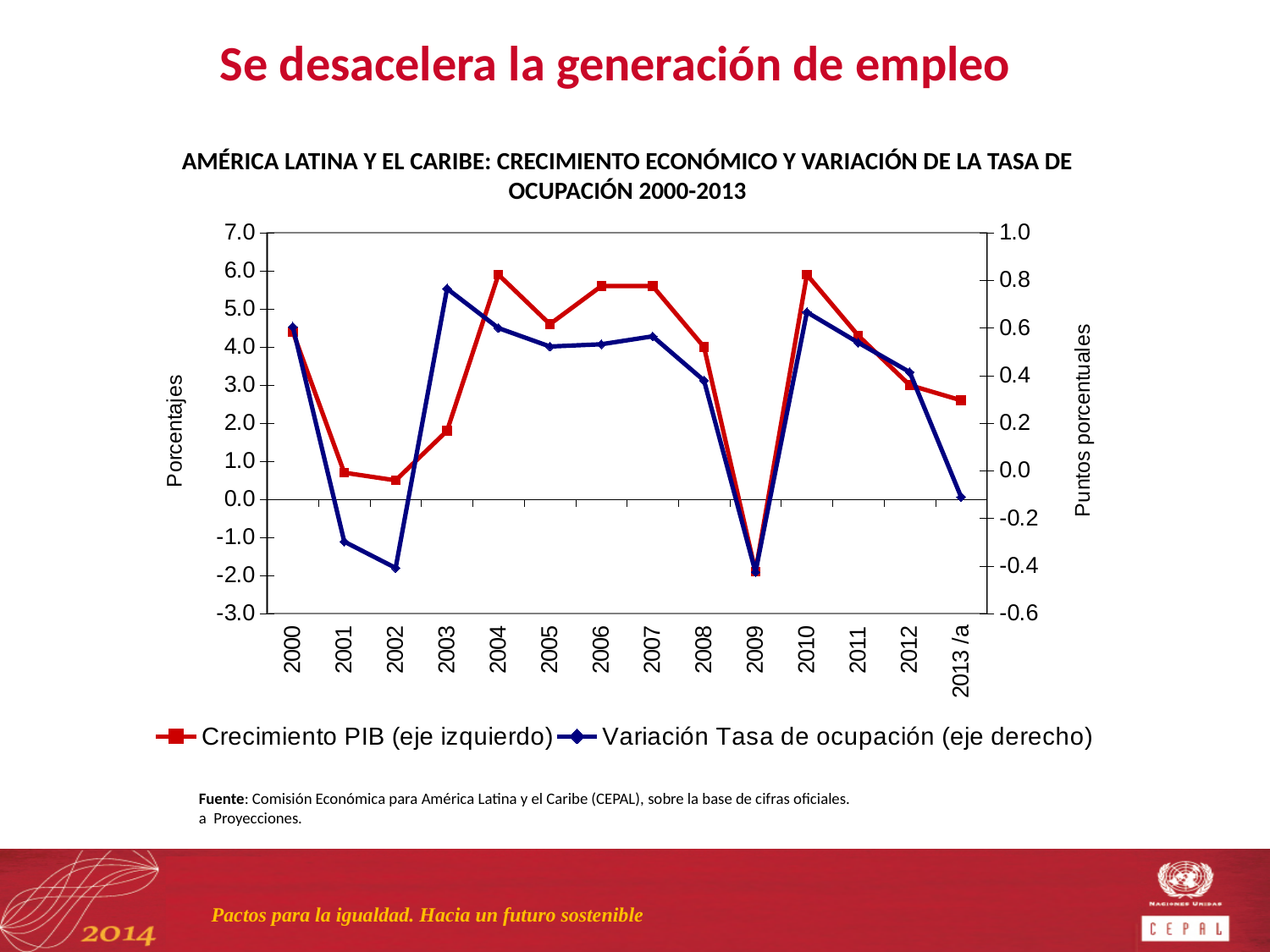
Is the value for Crecimiento PIB in 2002 greater or less than 1.0? less Is the value for Crecimiento PIB in 2009 greater or less than 0.0? less Does Crecimiento PIB rise or fall from 2010 to 2013 /a? fall Is the value for Crecimiento PIB in 2004 greater or less than 5.0? greater In which year is Crecimiento PIB at its lowest? 2009 How many years are plotted along the x axis? 14 How many series does the legend list? 2 In which year is Variación Tasa de ocupación at its highest? 2003 What kind of chart is shown on the slide? line chart Which series is plotted against the right axis (eje derecho)? Variación Tasa de ocupación Which is larger, Crecimiento PIB in 2003 or in 2004? 2004